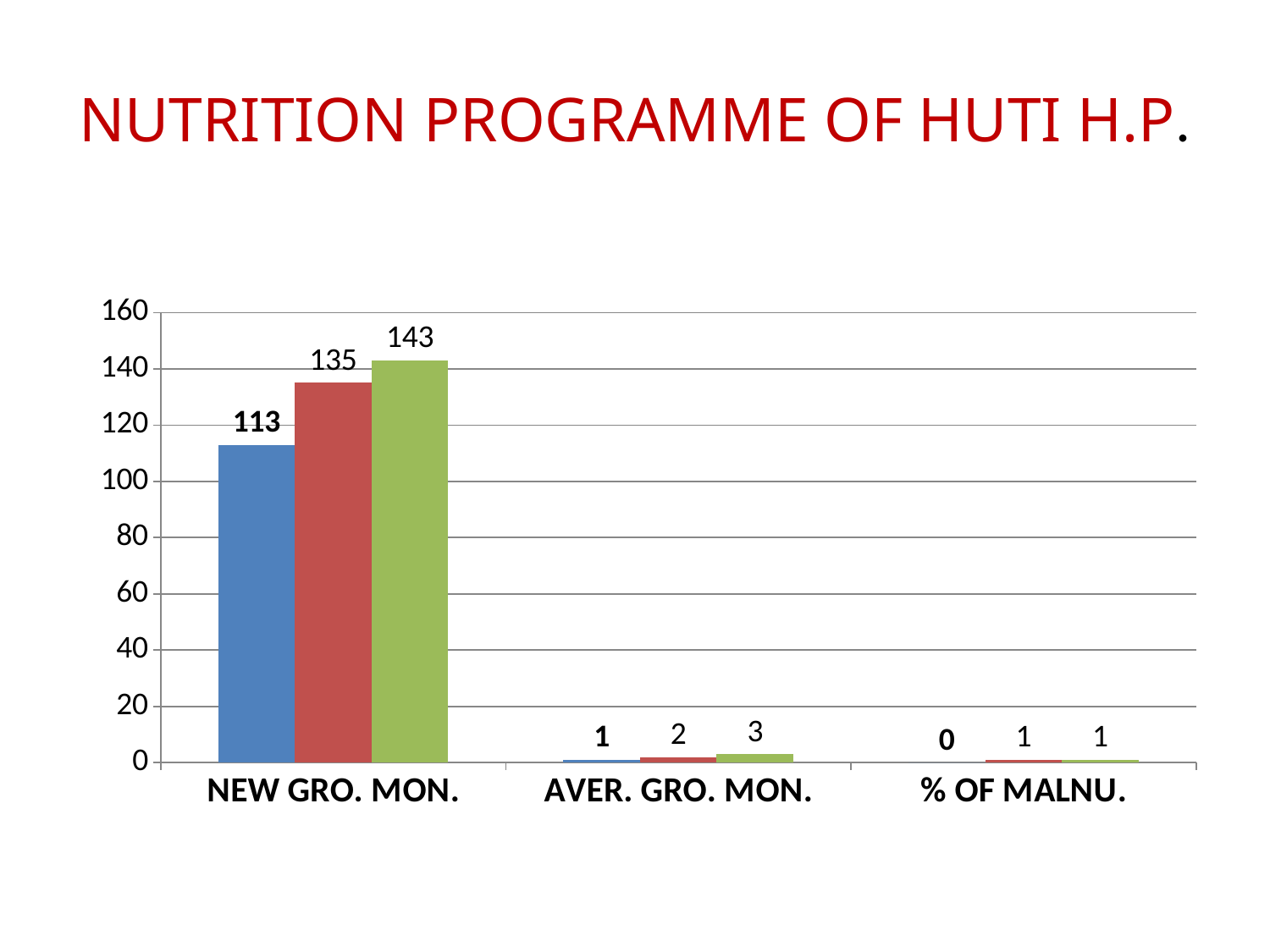
What is the value of the green bar for NEW GRO. MON.? 143 What is the value of the blue bar for % OF MALNU.? 0 Which is larger for NEW GRO. MON., the red bar or the green bar? green bar What is the value of the blue bar for NEW GRO. MON.? 113 What is the title of the slide containing the chart? NUTRITION PROGRAMME OF HUTI H.P. What is the difference between the red bar and the blue bar for NEW GRO. MON.? 22 What is the value of the red bar for AVER. GRO. MON.? 2 Is the value of the red bar for NEW GRO. MON. greater or less than 120? greater What is the difference between the green bar and the blue bar for NEW GRO. MON.? 30 What type of chart is shown on the slide? bar chart Which category has the highest values in the chart? NEW GRO. MON. How many categories are shown on the x axis of the chart? 3